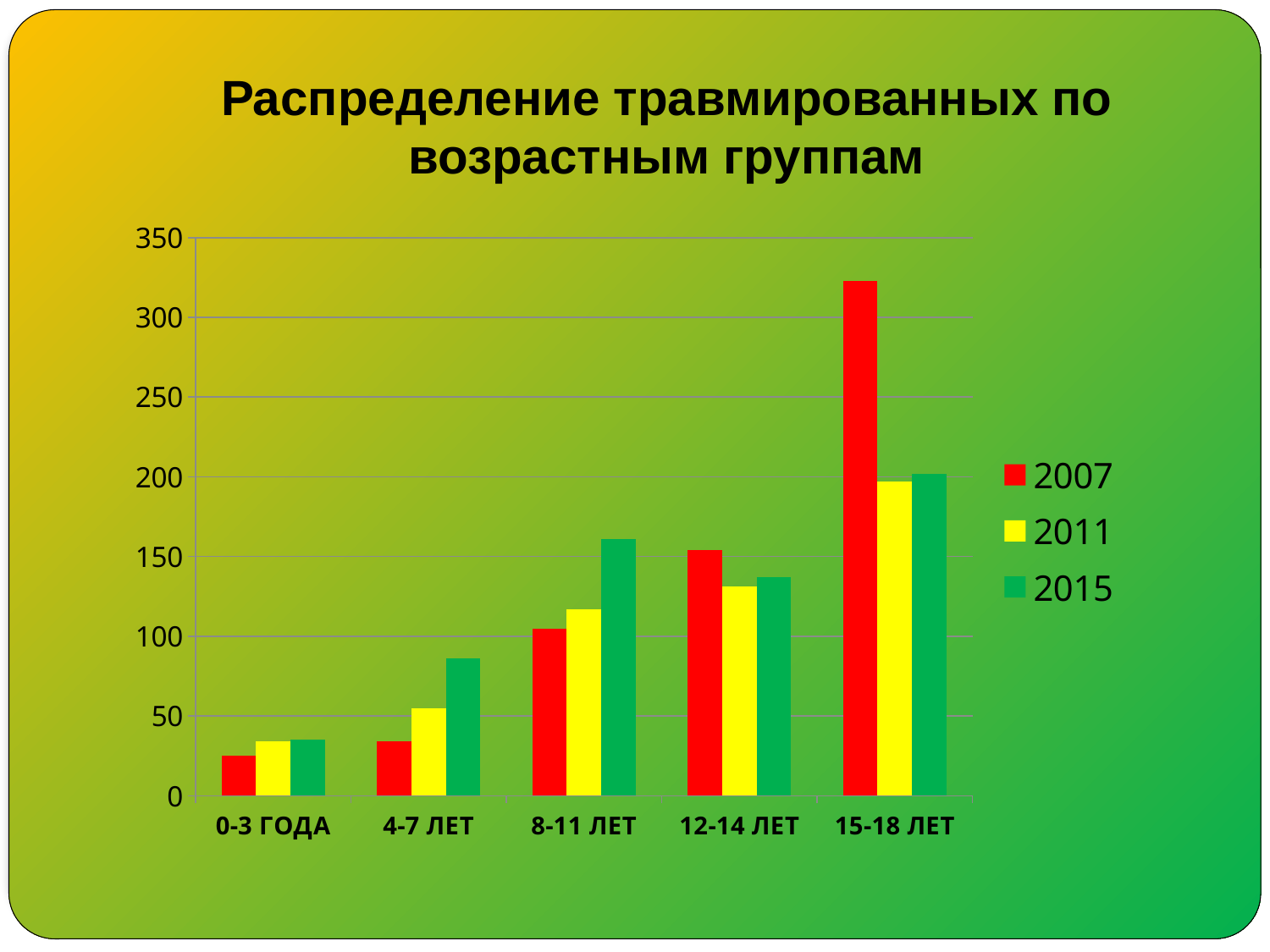
In the 8-11 ЛЕТ group, which series has the larger value, 2007 or 2015? 2015 What kind of chart is shown on the slide? bar chart Is the value for 2007 in the 15-18 ЛЕТ group greater or less than 300? greater How many series does the legend list? 3 In the 12-14 ЛЕТ group, which series has the larger value, 2007 or 2011? 2007 How many age groups are shown on the x axis? 5 Is the value for 2015 in the 4-7 ЛЕТ group greater or less than 100? less What is the title of the chart? Распределение травмированных по возрастным группам Is the value for 2011 in the 8-11 ЛЕТ group greater or less than 100? greater Do the values for the 2011 series rise or fall from the 0-3 ГОДА group to the 15-18 ЛЕТ group? rise Which age group has the lowest value for 2007? 0-3 ГОДА Which age group has the highest value for 2007? 15-18 ЛЕТ